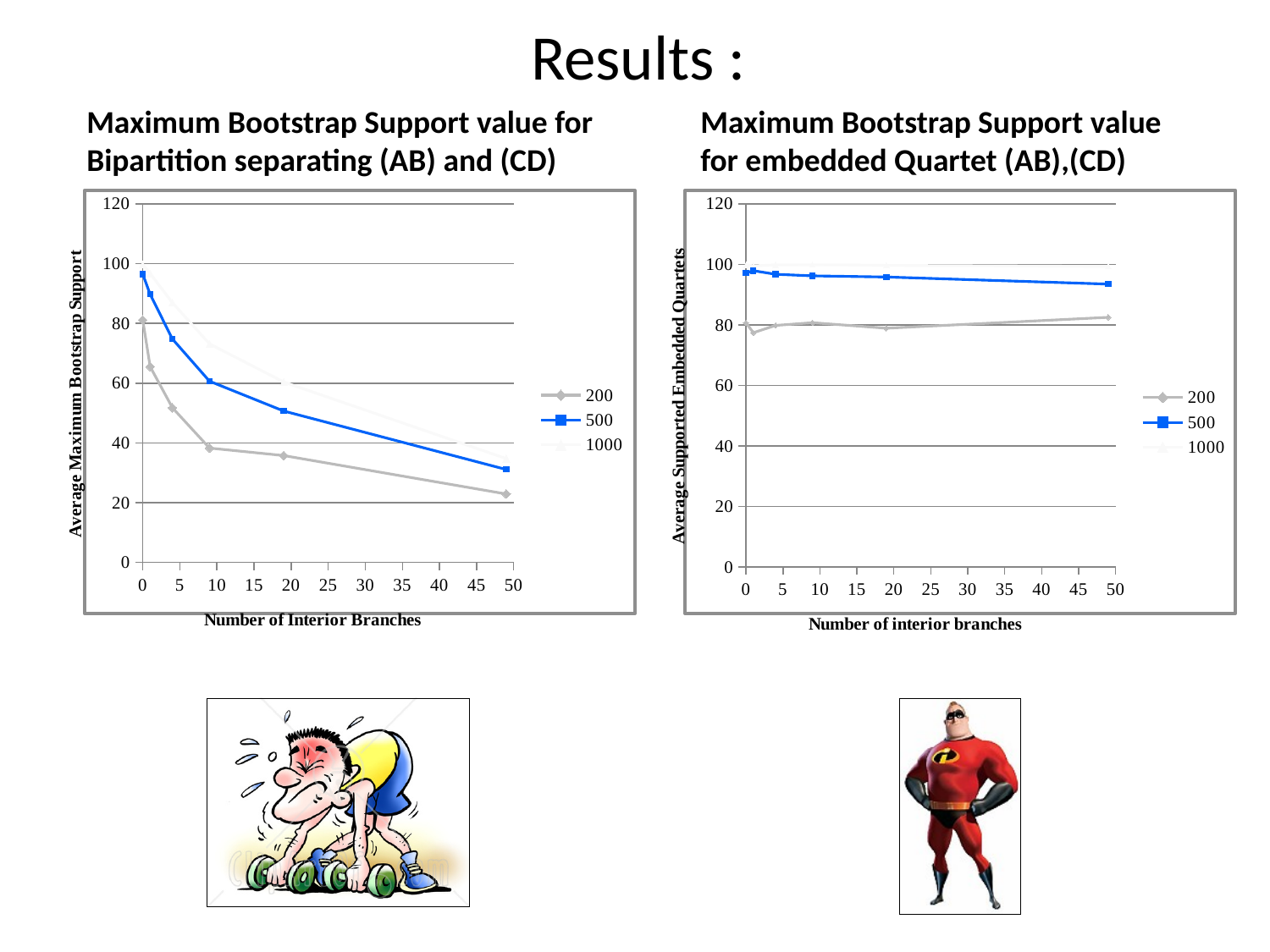
In the left chart, do the values of the 500 series rise or fall as the number of interior branches increases? fall How many series does the legend of the right chart, 'Maximum Bootstrap Support value for embedded Quartet (AB),(CD)', list? 3 In the right chart, is the value of the 200 series at 50 interior branches greater or less than 60? greater In the right chart, is the value of the 500 series at 0 interior branches greater or less than 80? greater What is the y-axis title of the right chart? Average Supported Embedded Quartets What kind of chart is the left chart, 'Maximum Bootstrap Support value for Bipartition separating (AB) and (CD)'? line chart In the left chart, is the value of the 500 series at 50 interior branches greater or less than 40? less In the left chart, at 10 interior branches, which series has the larger value, 200 or 500? 500 In the right chart, at 20 interior branches, which series has the larger value, 200 or 500? 500 What are the legend entries of the left chart? 200, 500, 1000